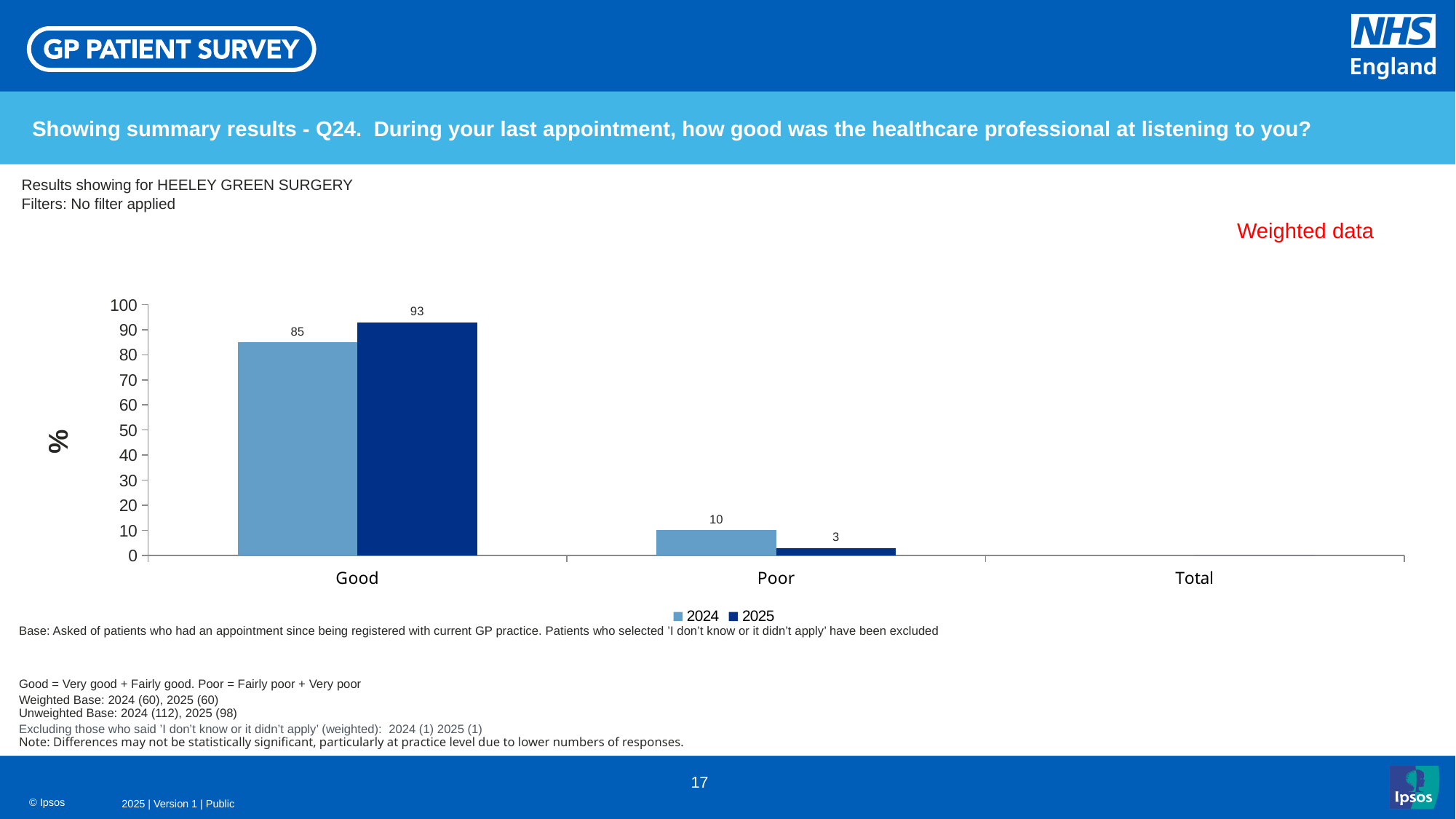
What is the value for Poor in 2024? 10 Which is larger for Good: the 2024 value or the 2025 value? 2025 Which category has the highest value for 2025? Good What is the difference between the 2024 and 2025 values for Poor? 7 What is the difference between the 2025 and 2024 values for Good? 8 What is the label on the vertical axis of the chart? % What is the value for Good in 2025? 93 How many series does the legend list? 2 What is the value for Poor in 2025? 3 Is the value for Poor in 2024 greater or less than 20? less What is the value for Good in 2024? 85 What kind of chart is shown on the slide? Bar chart